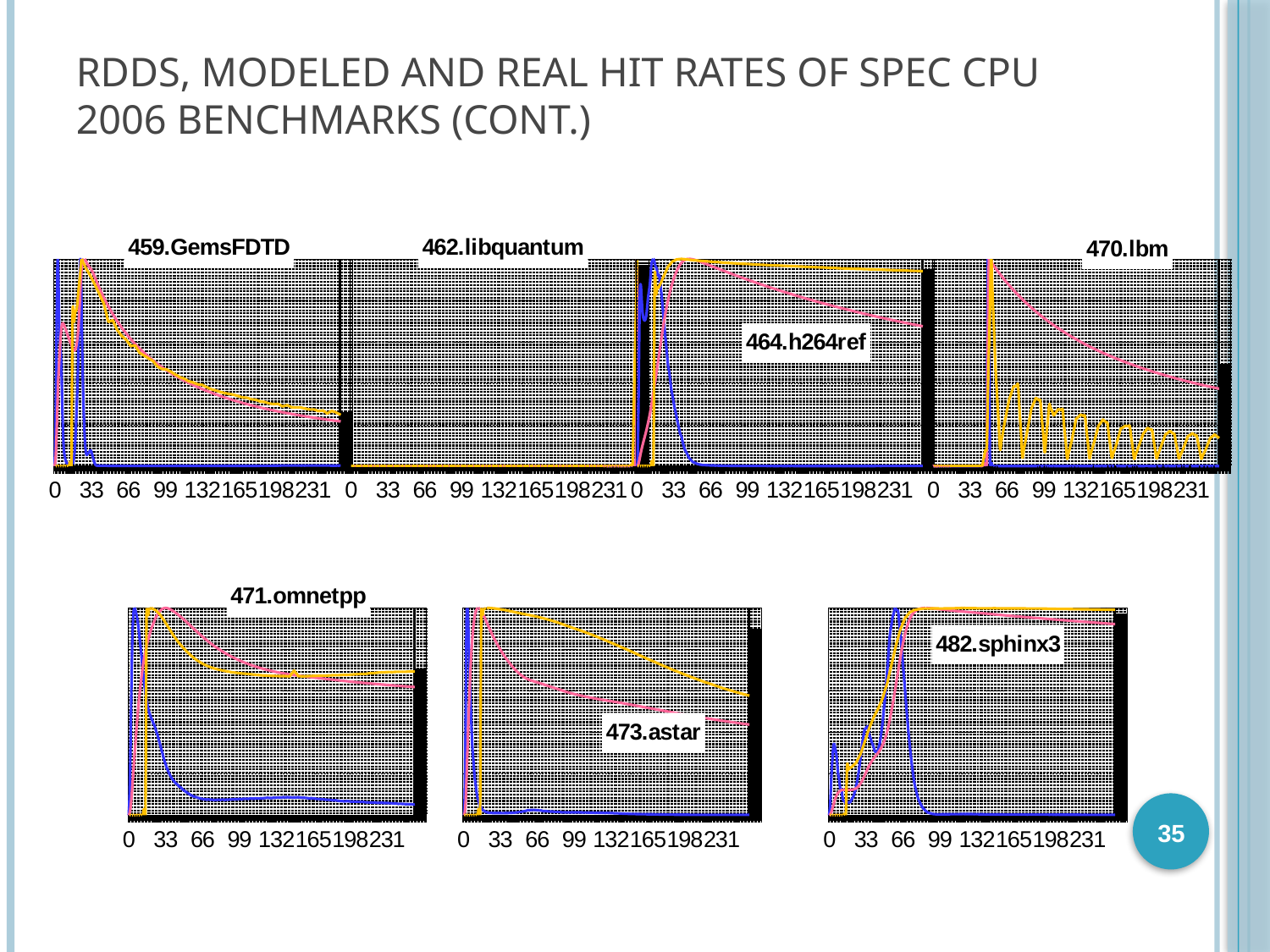
What kind of chart is used for 459.GemsFDTD? line chart What is the x-axis tick label that follows 99 on the 462.libquantum chart? 132 How many x-axis tick labels are printed under the 473.astar chart? 8 In the 473.astar chart, does the orange line rise or fall from left to right after its initial peak? fall In the 464.h264ref chart, does the blue line rise or fall between x = 33 and x = 66? fall How many charts are shown on the slide? 7 In the 459.GemsFDTD chart, does the orange line rise or fall along the x axis after its peak near 33? fall What is the largest x-axis tick label shown on the 471.omnetpp chart? 231 Which benchmark chart is in the top-right position of the slide? 470.lbm